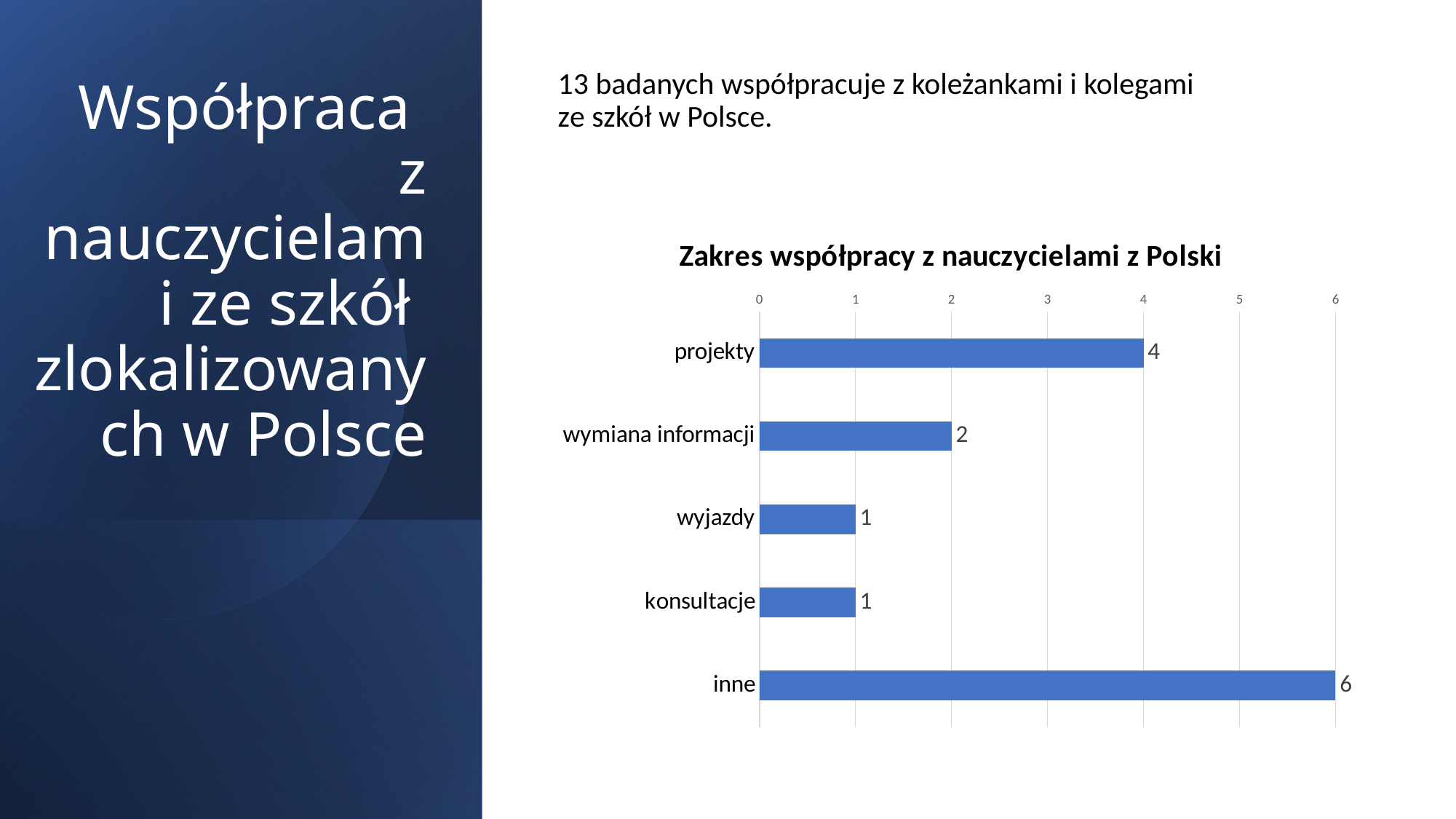
Which is larger, the value for projekty or the value for wymiana informacji? projekty Is the value for inne greater or less than 5? greater What is the value for wyjazdy? 1 What is the value for projekty? 4 What is the difference between the values for inne and projekty? 2 What is the value for wymiana informacji? 2 What kind of chart is shown on the slide? bar chart How many categories are shown in the chart? 5 What is the value for inne? 6 What is the title of the chart? Zakres współpracy z nauczycielami z Polski Which category has the highest value? inne What is the difference between the values for wymiana informacji and konsultacje? 1